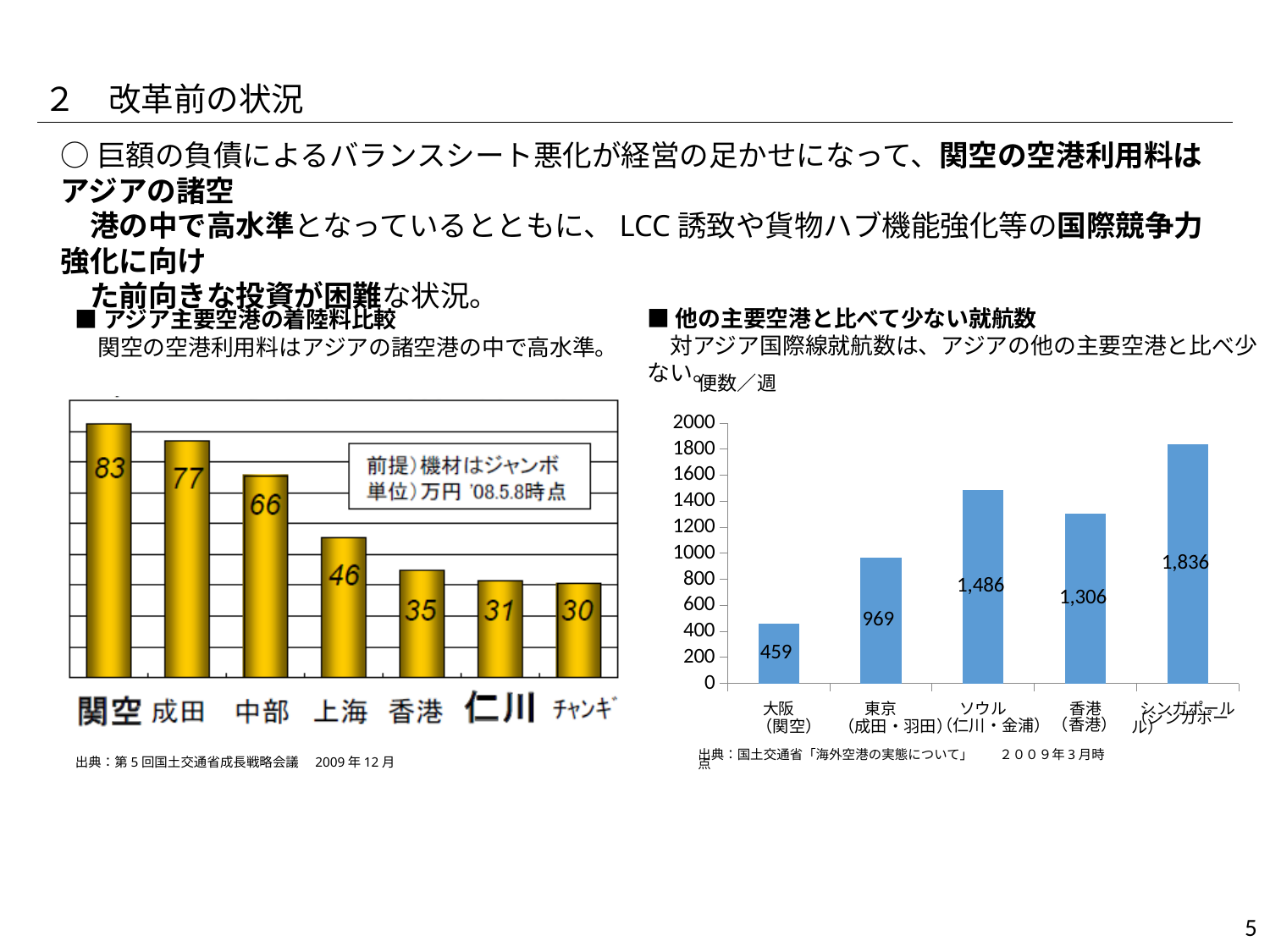
In the right chart (便数／週), which airport has the highest value? シンガポール In the right chart (便数／週), what is the difference between the values for 東京（成田・羽田） and 大阪（関空）? 510 In the right chart (便数／週), what is the value for ソウル（仁川・金浦）? 1,486 In the left chart (アジア主要空港の着陸料比較), what is the difference between the values for 関空 and 成田? 6 In the left chart (アジア主要空港の着陸料比較), what is the value for 上海? 46 In the left chart (アジア主要空港の着陸料比較), which airport has the lowest value? チャンギ In the right chart (便数／週), what is the value for 大阪（関空）? 459 In the left chart (アジア主要空港の着陸料比較), how many airports are shown? 7 In the left chart (アジア主要空港の着陸料比較), what is the value for 関空? 83 What kind of chart is the right chart (便数／週)? bar chart In the right chart (便数／週), which is larger, the value for ソウル（仁川・金浦） or 香港（香港）? ソウル（仁川・金浦） In the left chart (アジア主要空港の着陸料比較), do the values rise or fall from left to right? fall